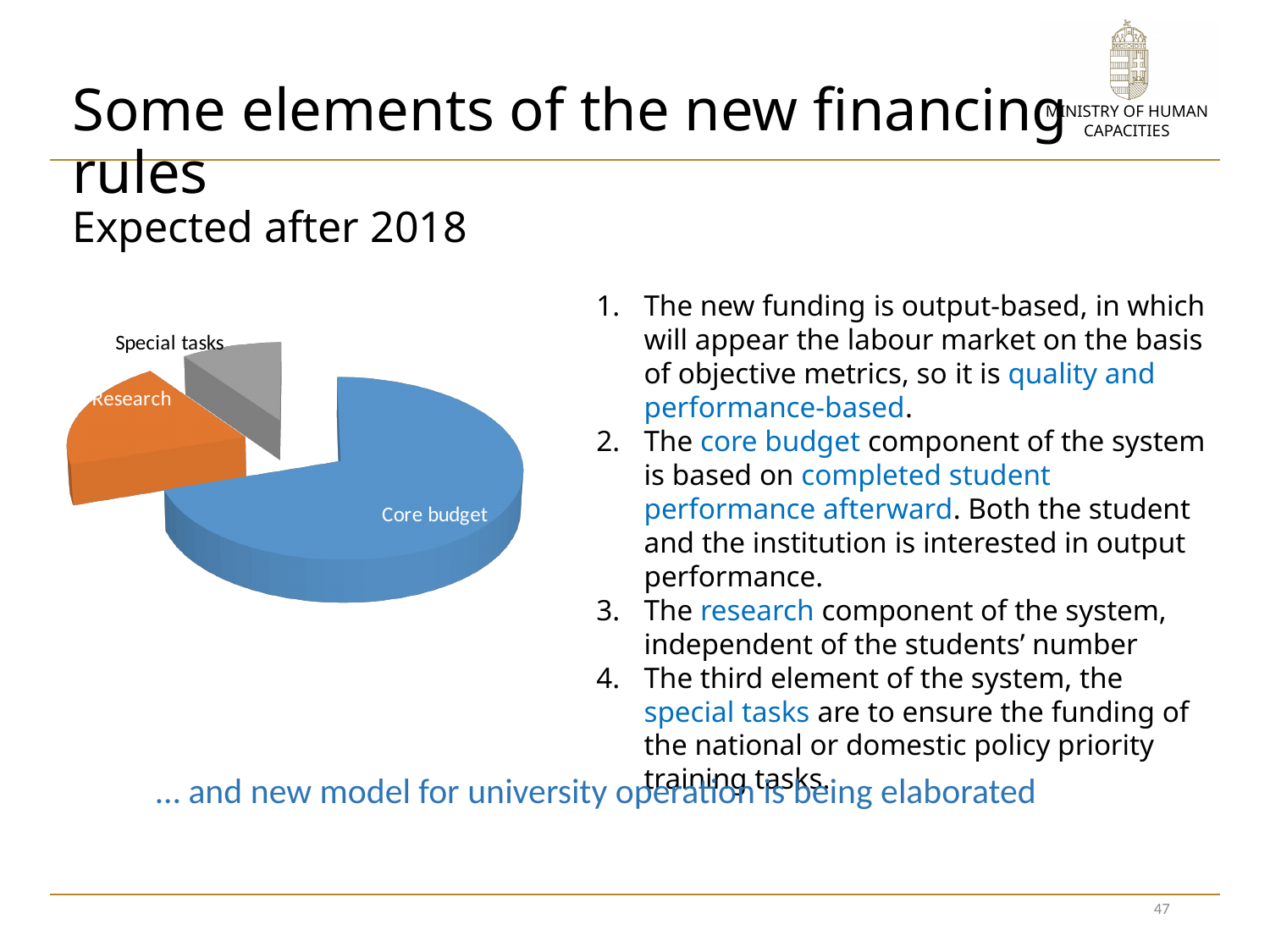
Which slice of the pie chart is the largest? Core budget What kind of chart is shown on the slide? Pie chart Which slice is larger in the pie chart, Research or Special tasks? Research How many slices does the pie chart have? 3 Which slice is larger in the pie chart, Core budget or Research? Core budget Which slice of the pie chart is the smallest? Special tasks Which slice of the pie chart is coloured orange? Research What colour is the Core budget slice in the pie chart? Blue